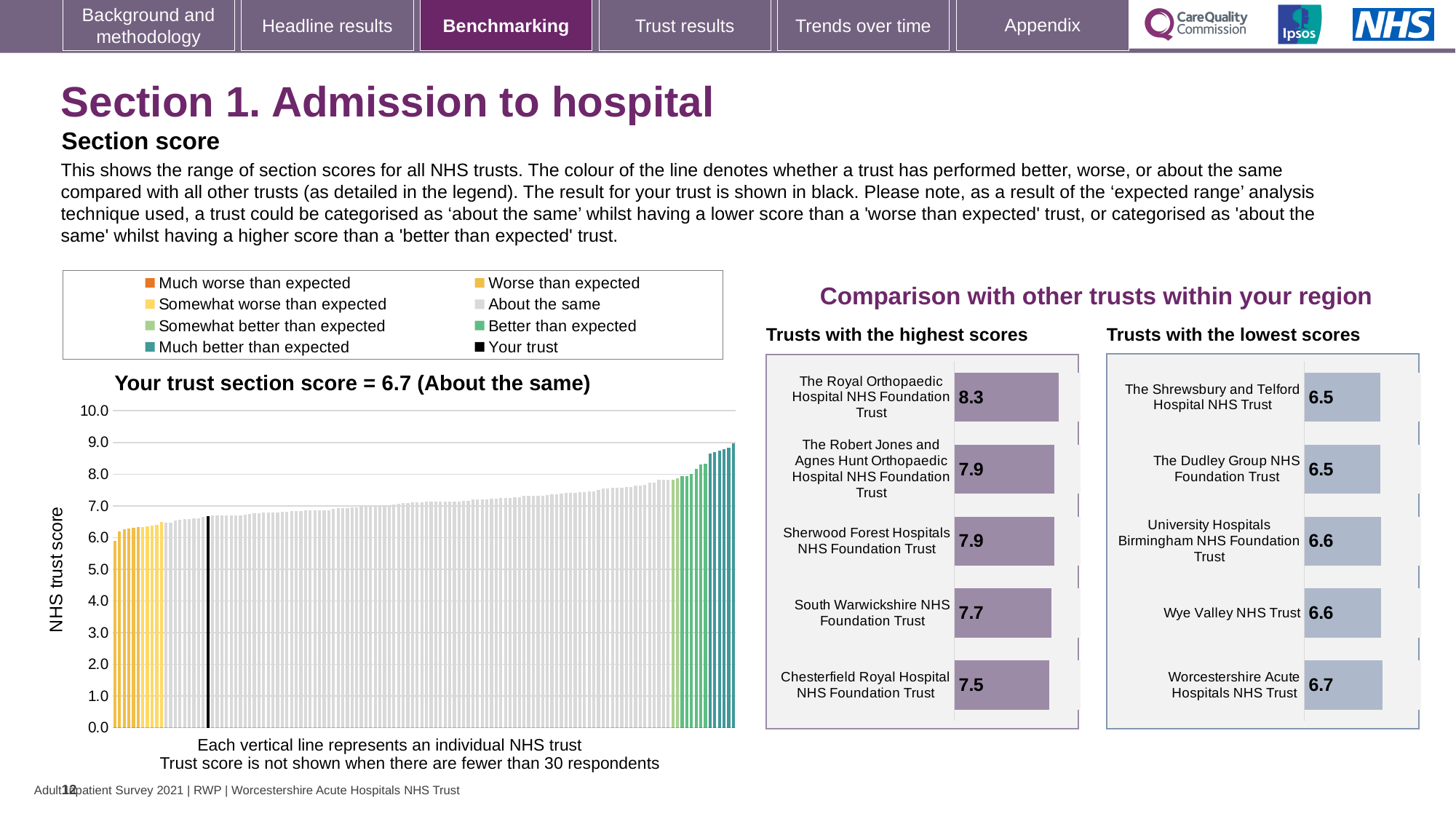
On the 'Trusts with the highest scores' chart, what is the difference between the scores of The Royal Orthopaedic Hospital NHS Foundation Trust and Chesterfield Royal Hospital NHS Foundation Trust? 0.8 On the 'Trusts with the highest scores' chart, what is the score for The Royal Orthopaedic Hospital NHS Foundation Trust? 8.3 What kind of chart is the 'Your trust section score' chart? bar chart On the 'Your trust section score' chart, do the trust scores rise or fall from left to right along the x axis? rise How many trusts are shown on the 'Trusts with the highest scores' chart? 5 On the 'Trusts with the lowest scores' chart, which trust has the highest score? Worcestershire Acute Hospitals NHS Trust On the 'Trusts with the lowest scores' chart, what is the score for Wye Valley NHS Trust? 6.6 On the 'Trusts with the lowest scores' chart, what is the difference between the scores of Worcestershire Acute Hospitals NHS Trust and The Dudley Group NHS Foundation Trust? 0.2 How many entries does the legend above the 'Your trust section score' chart list? 8 On the 'Trusts with the highest scores' chart, which trust has the lowest score? Chesterfield Royal Hospital NHS Foundation Trust On the 'Your trust section score' chart, what is the section score for your trust? 6.7 On the 'Your trust section score' chart, is the value for your trust greater or less than 7.0? less